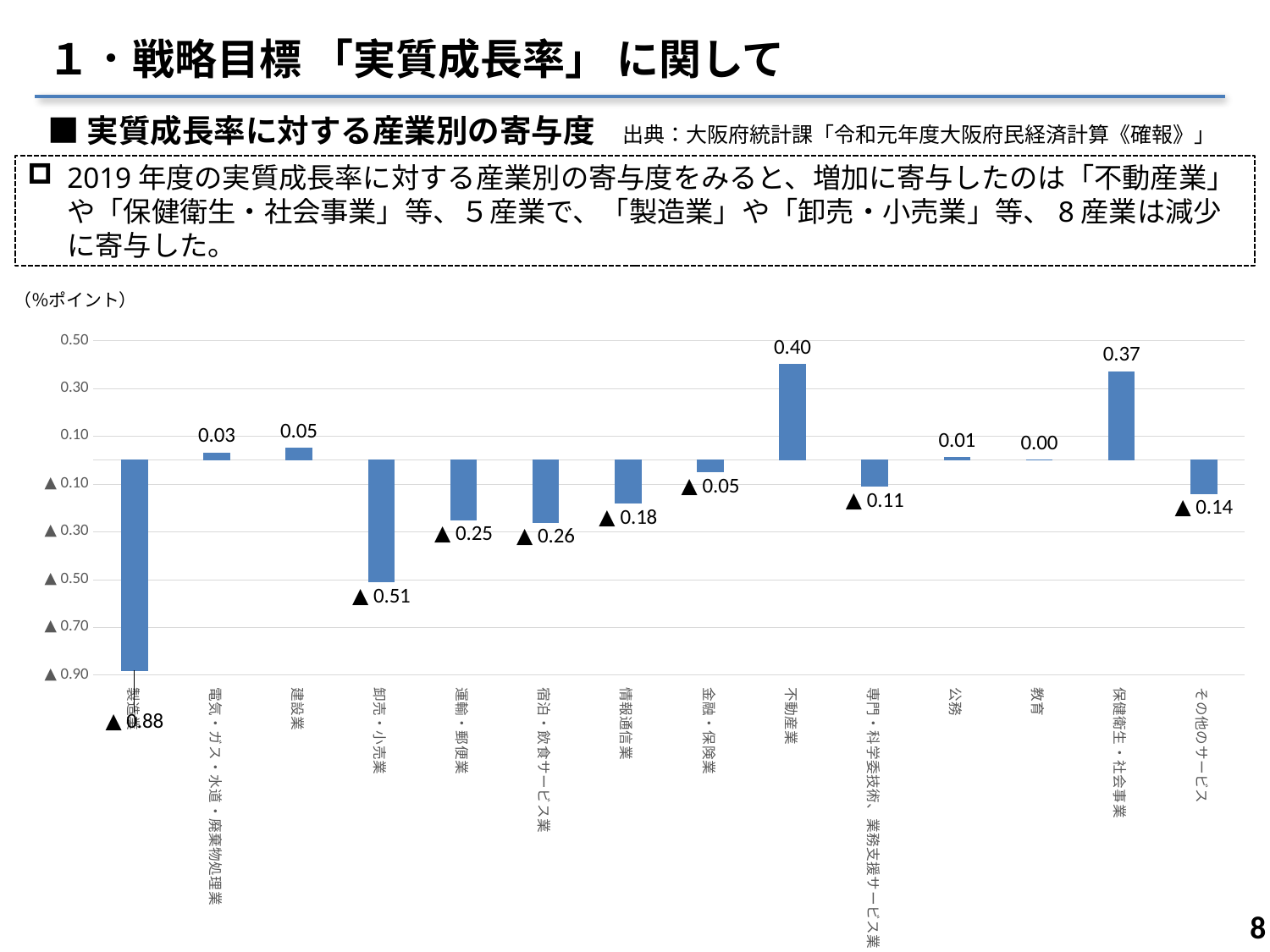
What kind of chart is shown on the slide? bar chart What is the value for 製造業? ▲0.88 What unit is indicated above the chart's vertical axis? (%ポイント) Is the value for 製造業 greater or less than ▲0.70? less What is the value for 不動産業? 0.40 What is the value for 保健衛生・社会事業? 0.37 Which is larger, the value for 建設業 or the value for 電気・ガス・水道・廃棄物処理業? 建設業 What is the difference between the values for 不動産業 and 保健衛生・社会事業? 0.03 What is the value for 卸売・小売業? ▲0.51 Which industry has the highest value? 不動産業 How many industries are shown on the x axis? 14 Which industry has the lowest value? 製造業